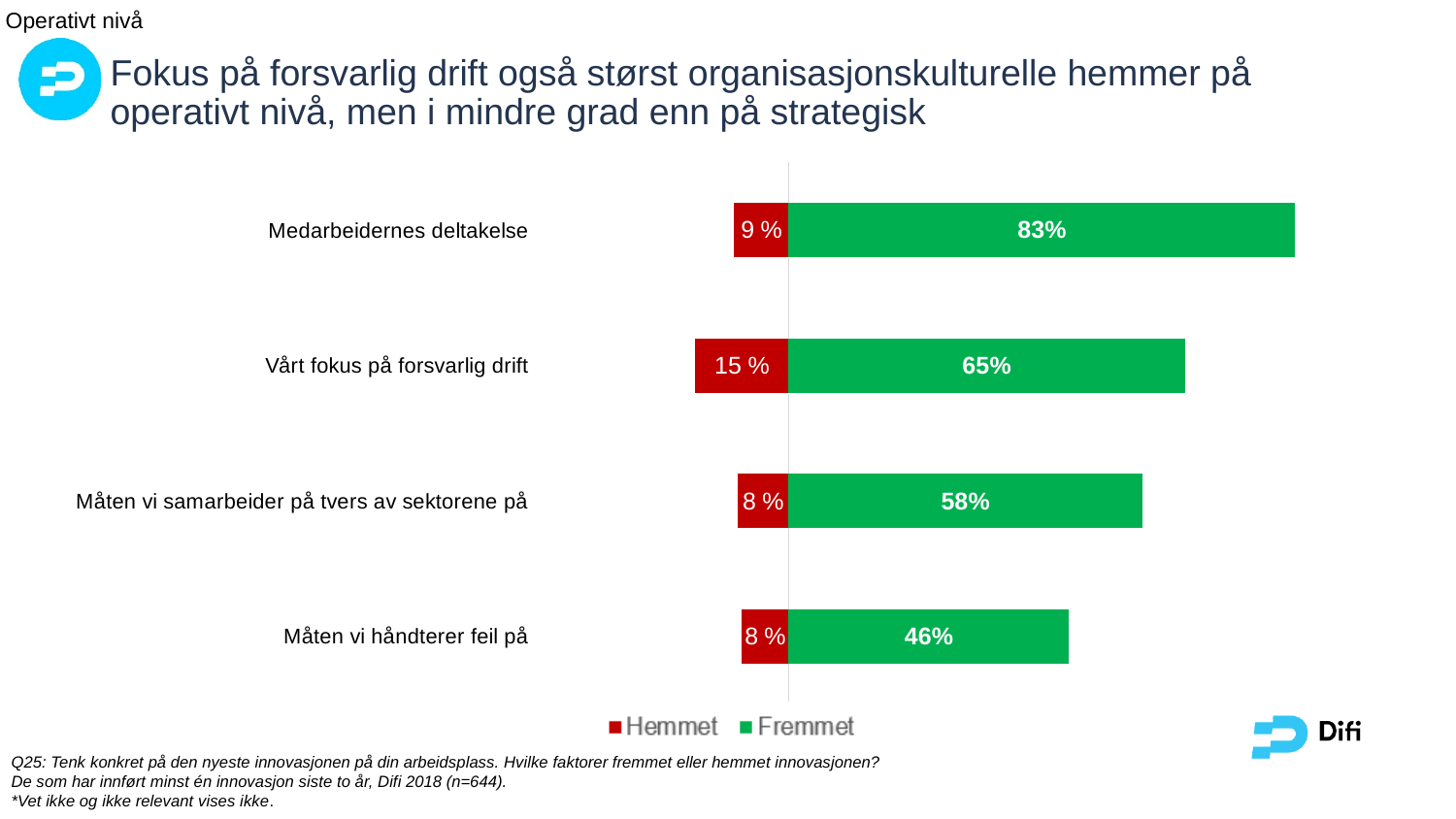
Which is larger: the Fremmet value for Måten vi samarbeider på tvers av sektorene på or for Måten vi håndterer feil på? Måten vi samarbeider på tvers av sektorene på Which colour represents the Hemmet series in the chart? Red How many series does the legend list? 2 Which category has the lowest Fremmet value? Måten vi håndterer feil på What kind of chart is shown on the slide? Bar chart What is the Fremmet value for Medarbeidernes deltakelse? 83% What is the difference between the Fremmet values for Medarbeidernes deltakelse and Vårt fokus på forsvarlig drift? 18 percentage points How many categories are shown in the chart? 4 What is the Fremmet value for Måten vi håndterer feil på? 46% What is the Hemmet value for Måten vi samarbeider på tvers av sektorene på? 8 % Which category has the highest Hemmet value? Vårt fokus på forsvarlig drift What is the Hemmet value for Vårt fokus på forsvarlig drift? 15 %